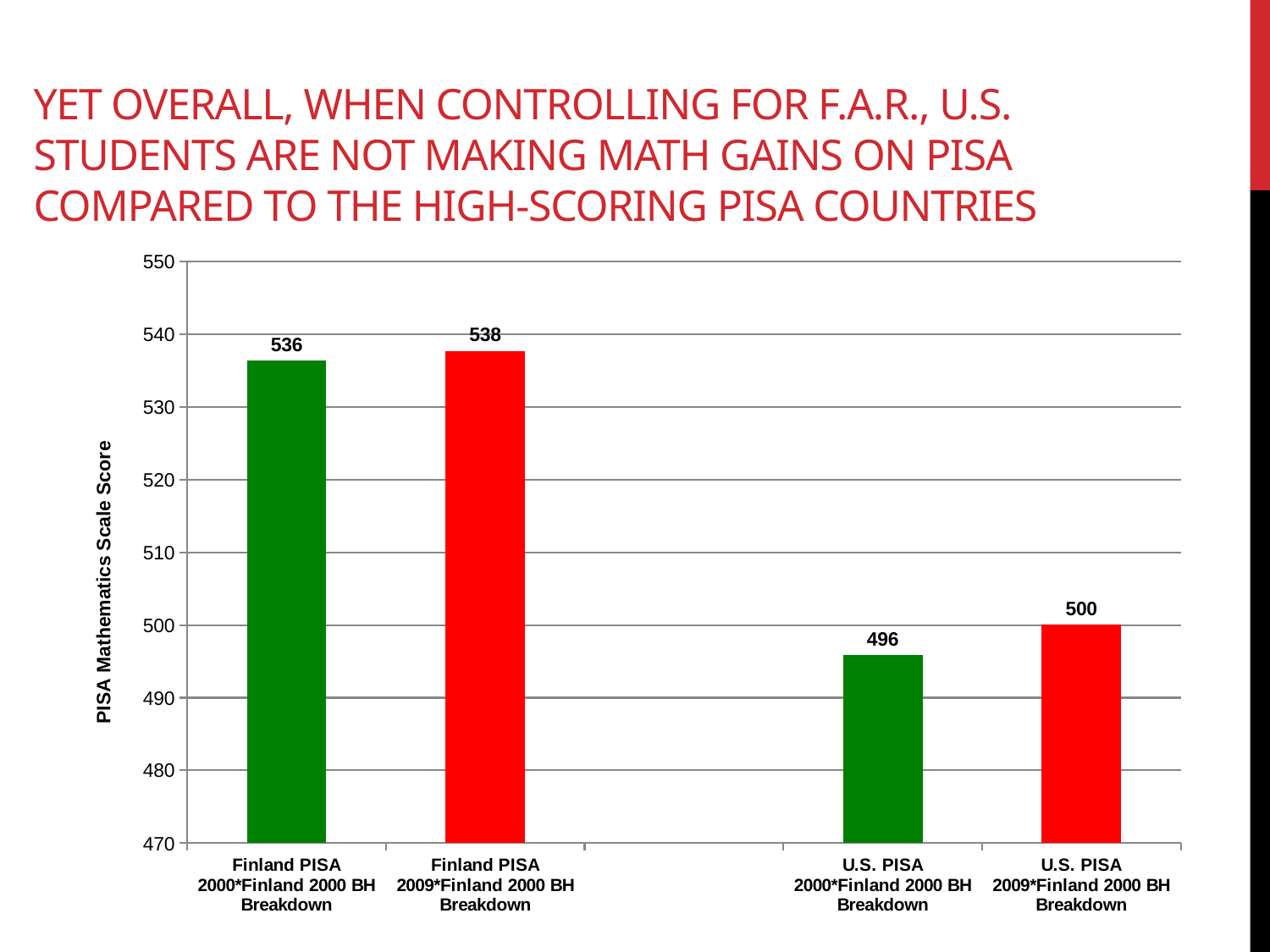
Which category has the lowest PISA Mathematics Scale Score? U.S. PISA 2000*Finland 2000 BH Breakdown Which is larger, the Finland PISA 2000 score or the U.S. PISA 2009 score? Finland PISA 2000 What is the PISA Mathematics Scale Score for Finland PISA 2000*Finland 2000 BH Breakdown? 536 What kind of chart is shown on the slide? Bar chart By how much did the U.S. PISA score increase from 2000 to 2009? 4 What is the label of the vertical axis? PISA Mathematics Scale Score Which category has the highest PISA Mathematics Scale Score? Finland PISA 2009*Finland 2000 BH Breakdown What is the difference between the Finland PISA 2009 score and the U.S. PISA 2009 score? 38 Is the value for U.S. PISA 2000*Finland 2000 BH Breakdown greater or less than 500? less What is the PISA Mathematics Scale Score for U.S. PISA 2009*Finland 2000 BH Breakdown? 500 What is the value shown for U.S. PISA 2000*Finland 2000 BH Breakdown? 496 How many bars are plotted in the chart? 4